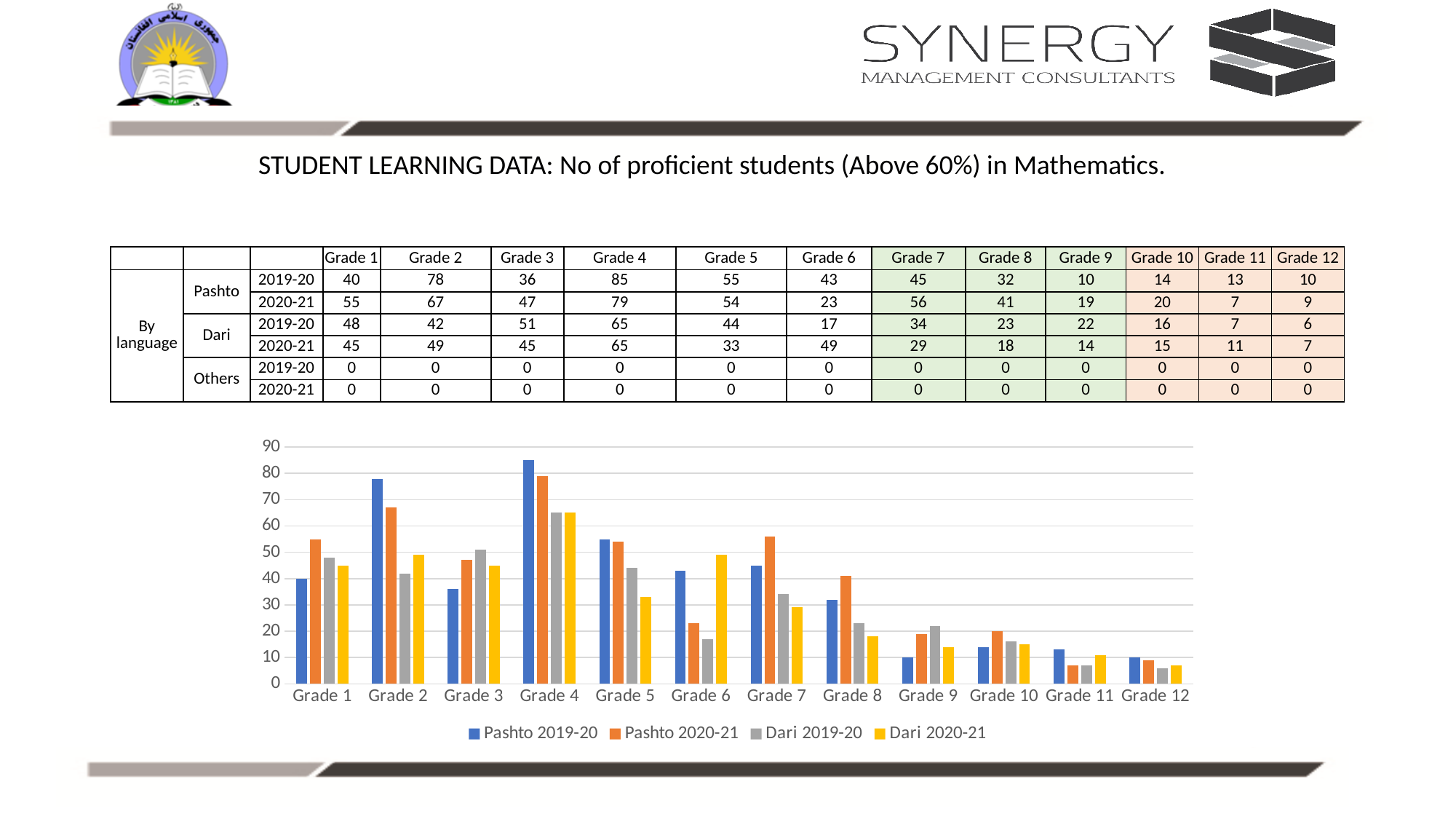
Which grade has the lowest value for Dari 2020-21? Grade 12 How many grade categories are plotted on the x axis of the chart? 12 What is the value for Pashto 2020-21 in Grade 7? 56 How many series does the chart legend list? 4 Is the value for Pashto 2020-21 in Grade 6 greater or less than 30? less Do the Dari 2019-20 values rise or fall from Grade 8 to Grade 12? fall What kind of chart is shown on the slide? bar chart In Grade 6, which is larger: Dari 2019-20 or Dari 2020-21? Dari 2020-21 Is the value for Pashto 2019-20 in Grade 2 greater or less than 70? greater What is the difference between Pashto 2019-20 and Pashto 2020-21 in Grade 4? 6 What colour represents Dari 2020-21 in the chart? yellow Which grade has the highest value for Pashto 2019-20 in the chart? Grade 4